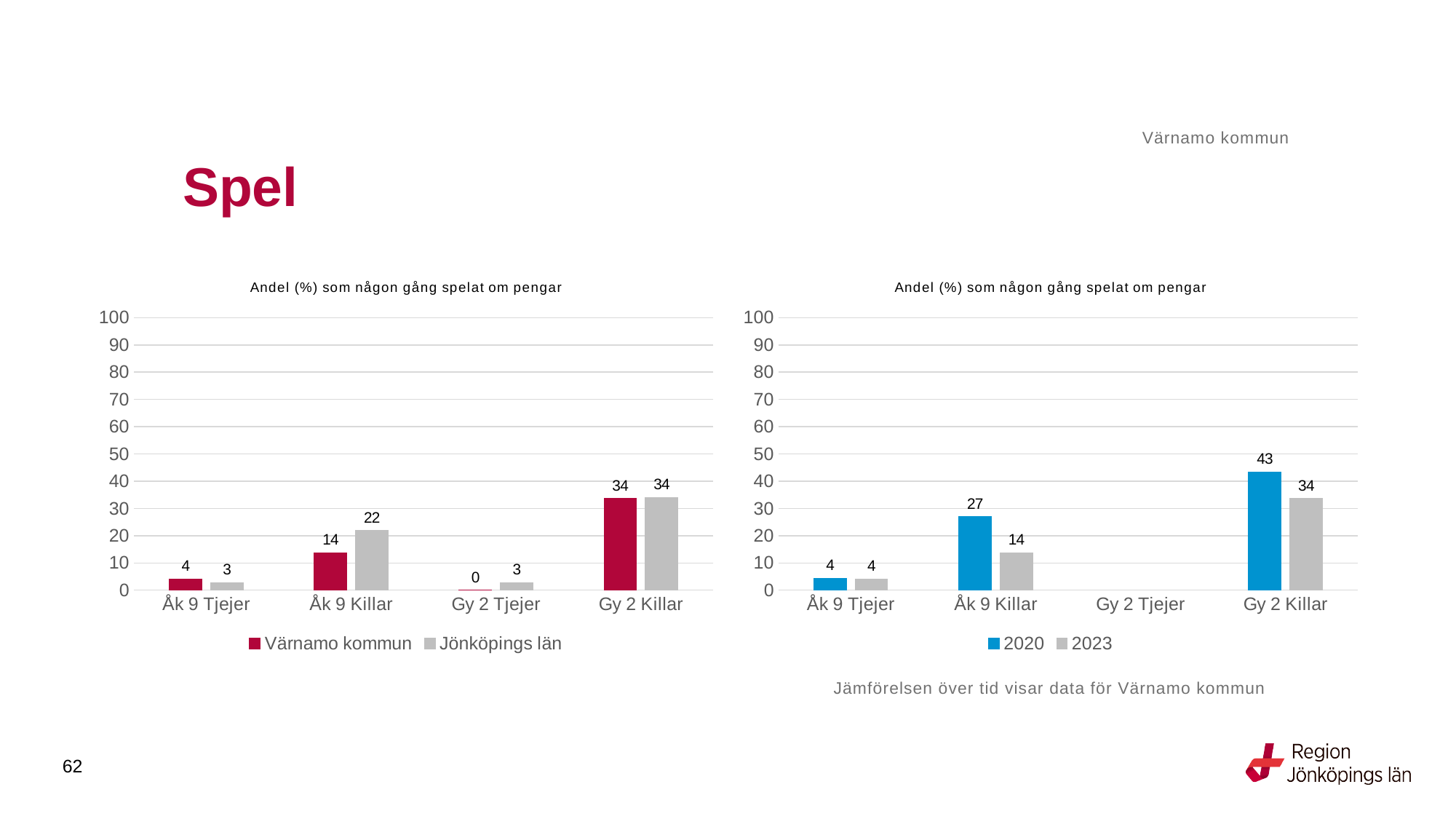
In the right chart, what is the value for 2023 for Åk 9 Killar? 14 In the right chart, which two series does the legend list? 2020 and 2023 In the left chart, what is the value for Jönköpings län for Åk 9 Killar? 22 In the right chart, what is the difference between 2020 and 2023 for Gy 2 Killar? 9 In the left chart, how many series does the legend list? 2 In the right chart, which is larger for Åk 9 Killar, 2020 or 2023? 2020 In the left chart, which category has the highest value for Värnamo kommun? Gy 2 Killar In the left chart, what is the difference between Jönköpings län and Värnamo kommun for Åk 9 Killar? 8 In the left chart, what is the value for Värnamo kommun for Gy 2 Tjejer? 0 What kind of chart is the right chart? Bar chart In the right chart, what is the value for 2020 for Gy 2 Killar? 43 In the left chart, what is the value for Värnamo kommun for Åk 9 Killar? 14